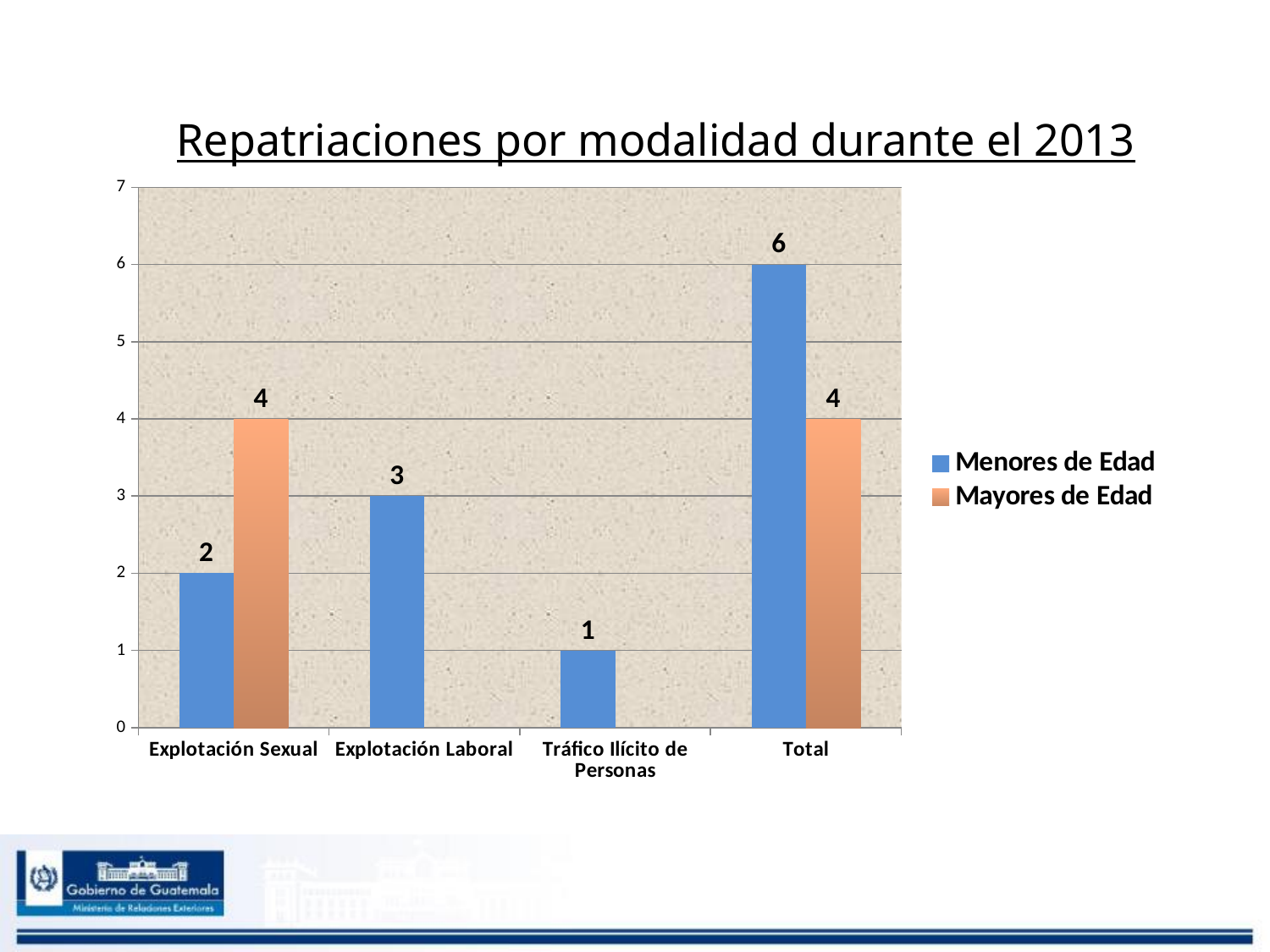
What is the value for Menores de Edad in the Explotación Laboral category? 3 What is the value for Mayores de Edad in the Explotación Sexual category? 4 Which category has the lowest value for Menores de Edad? Tráfico Ilícito de Personas How many series does the legend list? 2 What is the Total value for Mayores de Edad? 4 What is the value for Menores de Edad in the Tráfico Ilícito de Personas category? 1 What kind of chart is shown on the slide? Bar chart What is the value for Menores de Edad in the Explotación Sexual category? 2 In the Explotación Sexual category, which is larger: Menores de Edad or Mayores de Edad? Mayores de Edad Which category has the highest value for Menores de Edad? Total What is the title of the chart? Repatriaciones por modalidad durante el 2013 What is the difference between the Total values for Menores de Edad and Mayores de Edad? 2